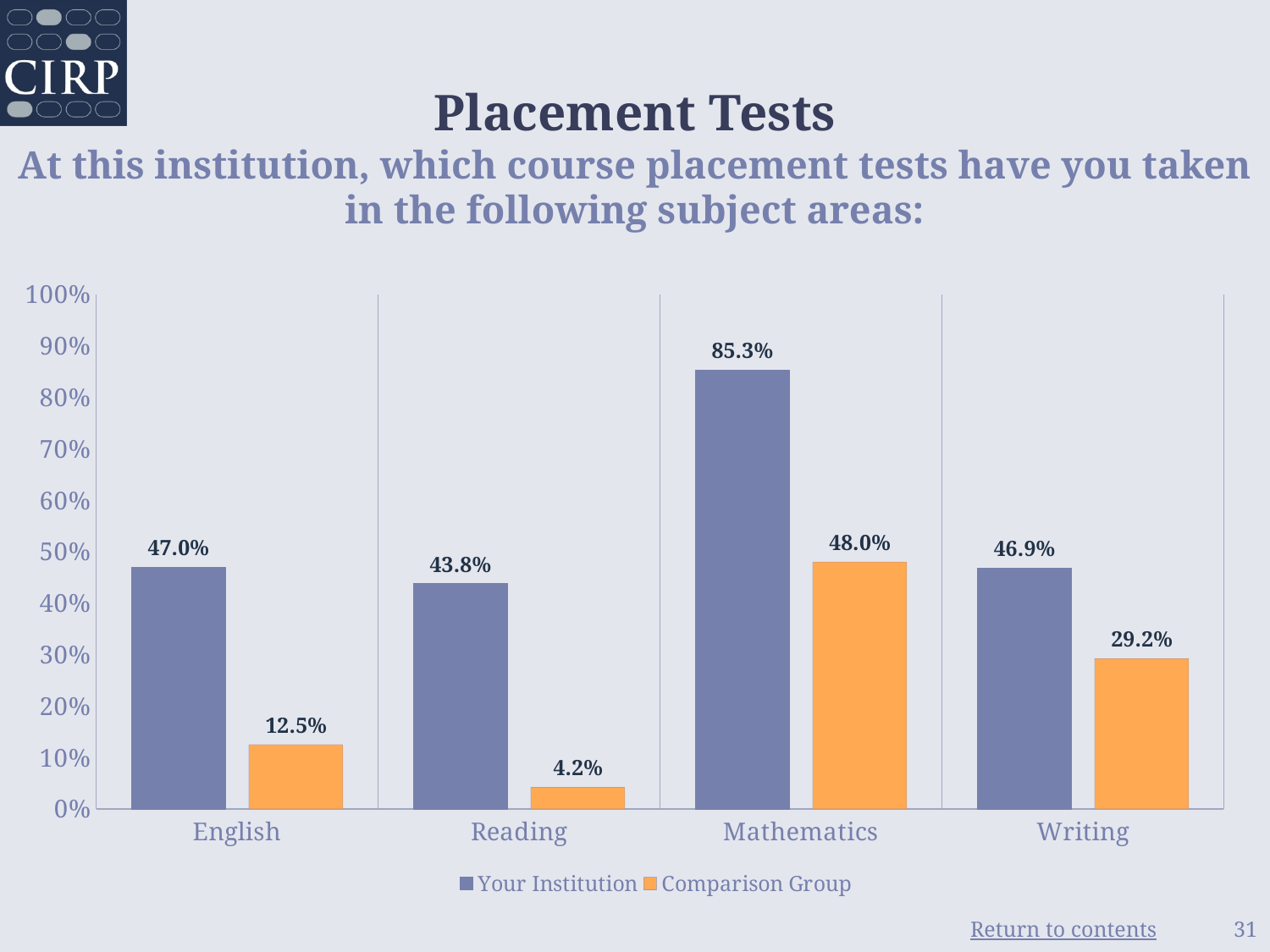
What is the value for the Comparison Group in Writing? 29.2% What is the value for the Comparison Group in Reading? 4.2% What kind of chart is shown on the slide? bar chart How many series does the legend list? 2 Which is larger: the Comparison Group value for Mathematics or the Your Institution value for English? Comparison Group value for Mathematics Is the value for Your Institution in Reading greater or less than 50%? less What is the difference between Your Institution and the Comparison Group in English? 34.5% What is the value for Your Institution in Mathematics? 85.3% How many subject areas are shown on the x axis? 4 Which subject area has the highest value for Your Institution? Mathematics What is the difference between Your Institution and the Comparison Group in Mathematics? 37.3% Which subject area has the lowest value for the Comparison Group? Reading